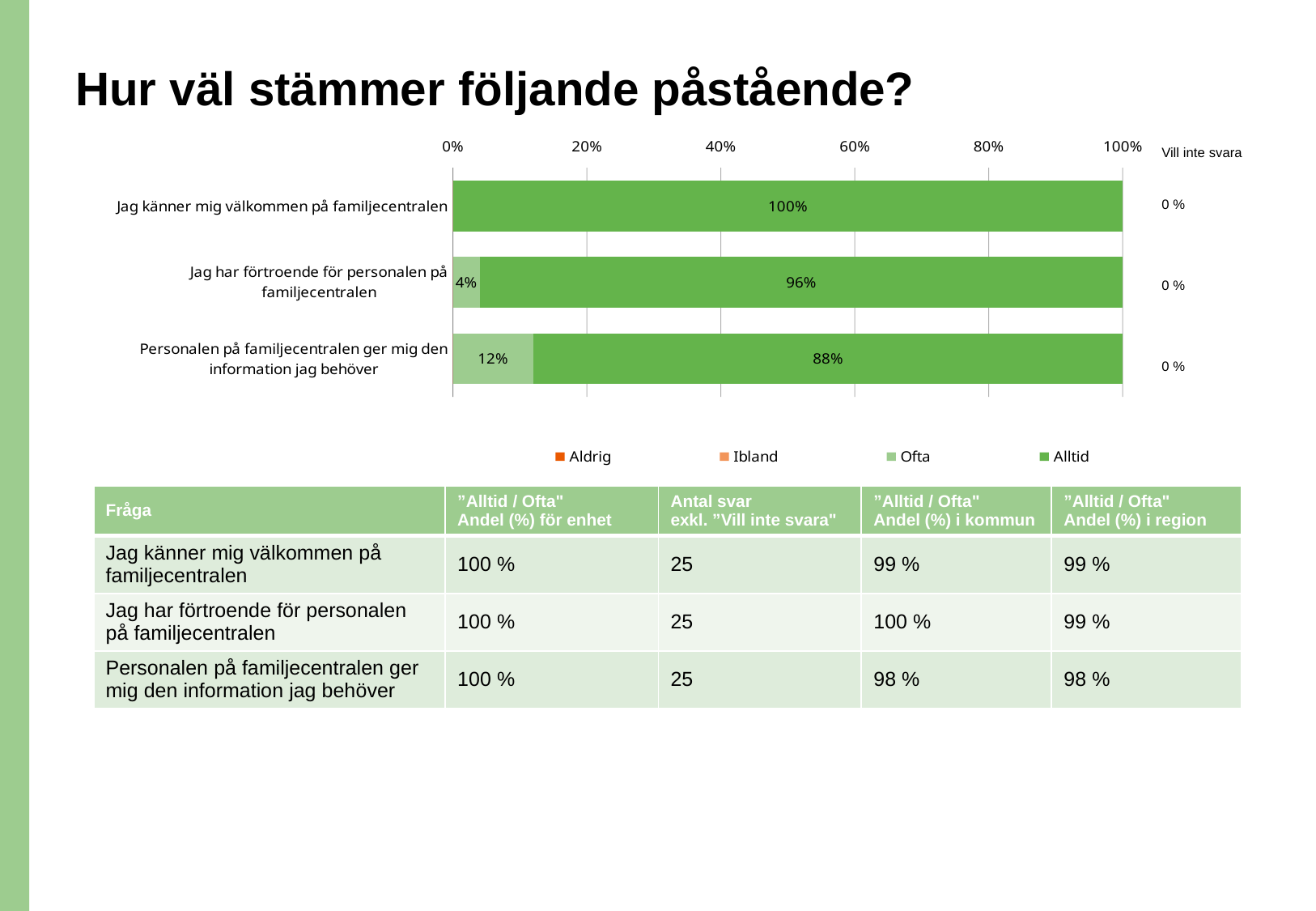
What is the difference between the "Alltid" values for "Jag har förtroende för personalen på familjecentralen" and "Personalen på familjecentralen ger mig den information jag behöver"? 8% Which is larger: the "Ofta" value for "Jag har förtroende för personalen på familjecentralen" or for "Personalen på familjecentralen ger mig den information jag behöver"? Personalen på familjecentralen ger mig den information jag behöver What is the "Alltid" value for "Jag känner mig välkommen på familjecentralen"? 100% What type of chart is shown on the slide? bar chart What is the "Alltid" value for "Personalen på familjecentralen ger mig den information jag behöver"? 88% Which statement has the highest "Alltid" value? Jag känner mig välkommen på familjecentralen What are the four legend entries of the chart? Aldrig, Ibland, Ofta, Alltid How many statements (categories) are plotted in the chart? 3 What is the "Ofta" value for "Personalen på familjecentralen ger mig den information jag behöver"? 12% What is the "Alltid" value for "Jag har förtroende för personalen på familjecentralen"? 96% Which statement has the lowest "Alltid" value? Personalen på familjecentralen ger mig den information jag behöver How many series does the chart legend list? 4